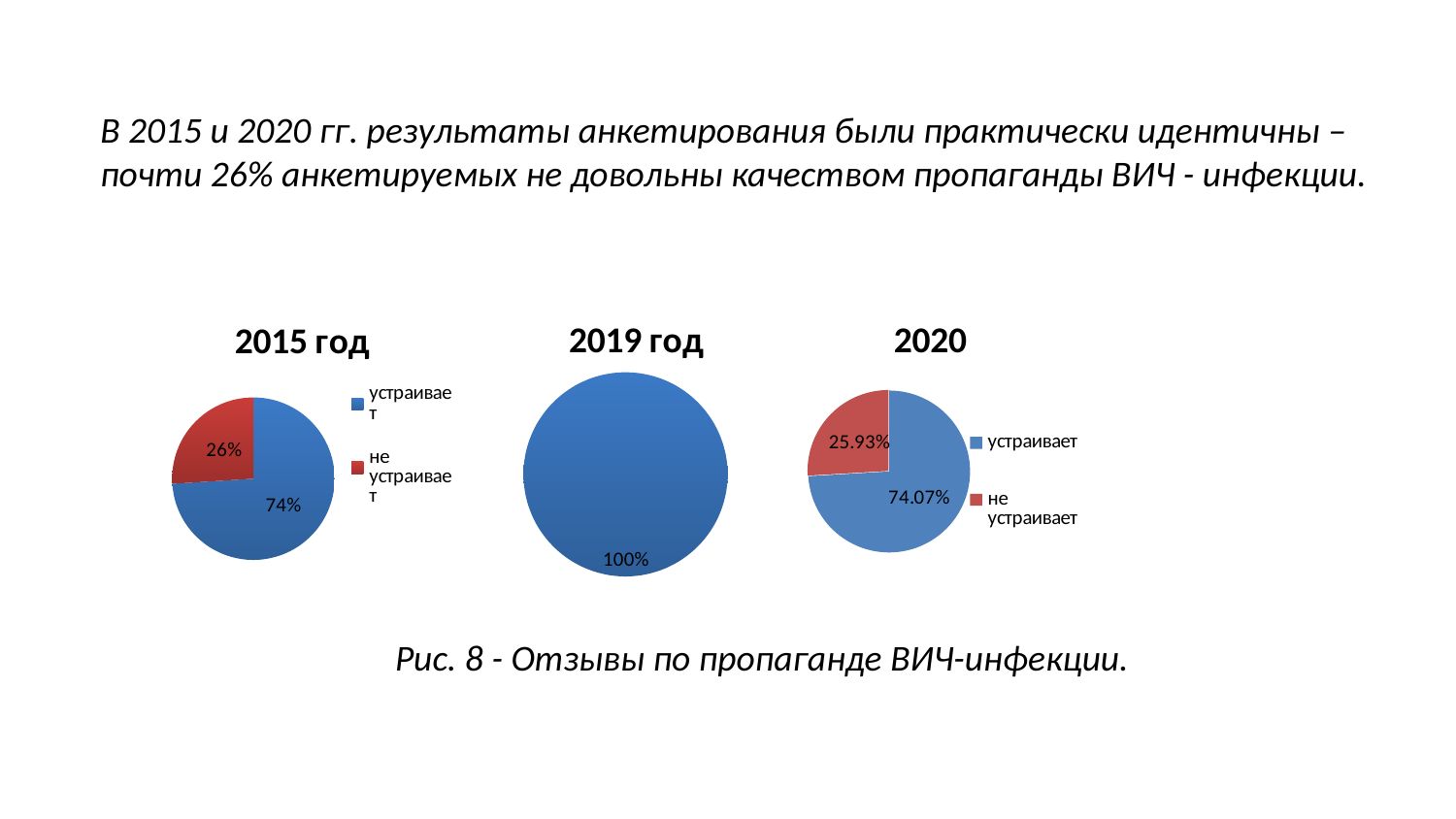
How many pie charts are shown on the slide? 3 In the chart titled "2019 год", what value is printed on the single slice? 100% How many entries does the legend of the chart titled "2020" list? 2 In the chart titled "2015 год", what share of the pie is labelled "не устраивает"? 26% In the chart titled "2020", what is the value for "устраивает"? 74.07% In the chart titled "2015 год", which category has the largest slice? устраивает In the chart titled "2020", what is the value for "не устраивает"? 25.93% In the chart titled "2015 год", what is the difference between the "устраивает" and "не устраивает" shares? 48% In the chart titled "2015 год", what share of the pie is labelled "устраивает"? 74% In the chart titled "2020", which is larger, "устраивает" or "не устраивает"? устраивает In the chart titled "2020", which category has the smallest slice? не устраивает What type of chart is the one titled "2020"? pie chart